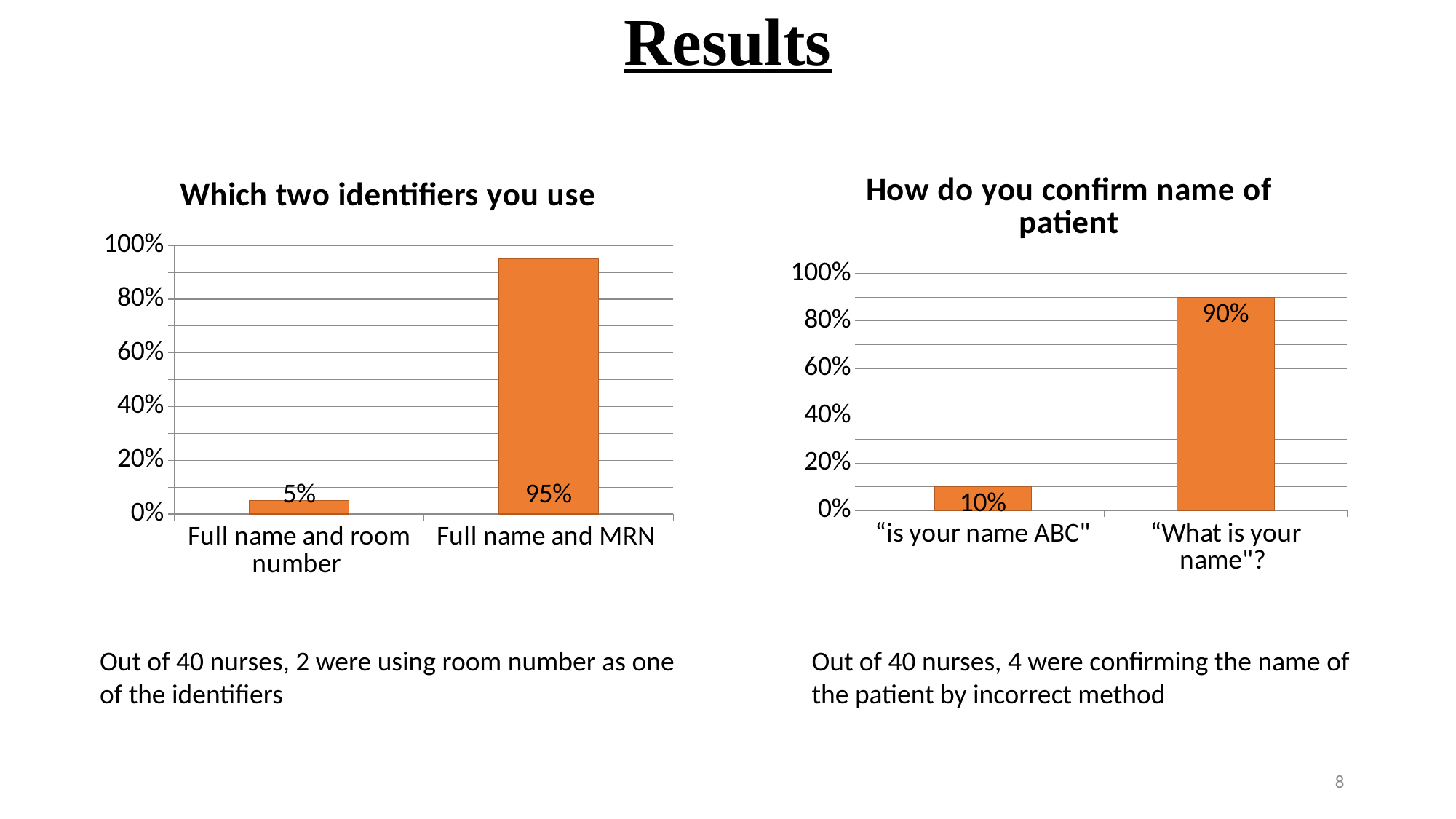
In the chart titled "How do you confirm name of patient", which category has the lowest value? is your name ABC In the chart titled "Which two identifiers you use", what is the value for "Full name and room number"? 5% In the chart titled "Which two identifiers you use", what is the difference between the values for "Full name and MRN" and "Full name and room number"? 90% In the chart titled "Which two identifiers you use", which category has the highest value? Full name and MRN In the chart titled "How do you confirm name of patient", what is the value for "is your name ABC"? 10% In the chart titled "Which two identifiers you use", what is the value for "Full name and MRN"? 95% What kind of chart is the chart titled "Which two identifiers you use"? bar chart In the chart titled "Which two identifiers you use", how many categories are shown? 2 In the chart titled "How do you confirm name of patient", what is the difference between the values for "What is your name" and "is your name ABC"? 80% In the chart titled "How do you confirm name of patient", what is the value for "What is your name"? 90% In the chart titled "How do you confirm name of patient", is the value for "What is your name" greater or less than 80%? greater What colour are the bars in the chart titled "How do you confirm name of patient"? orange